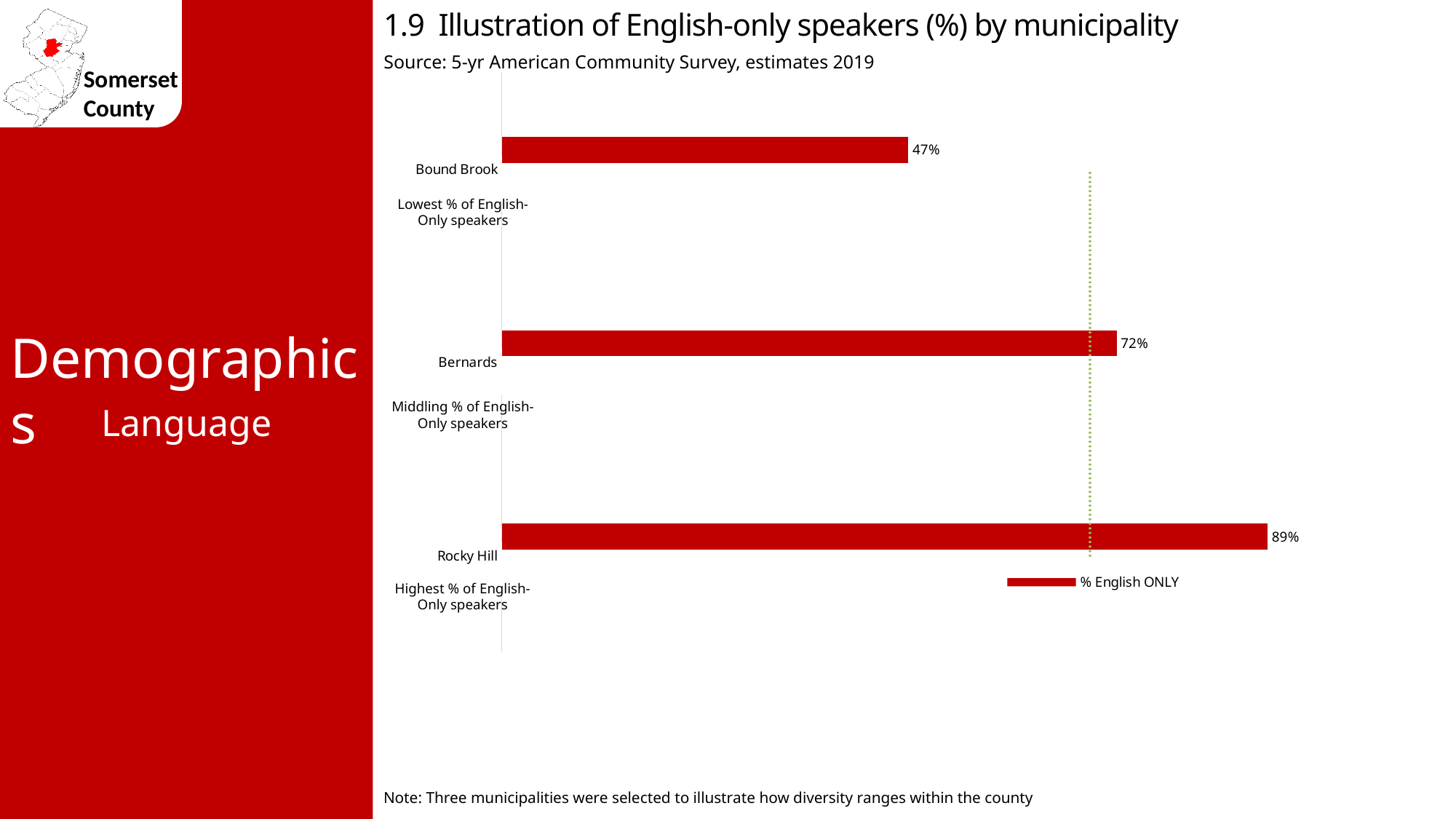
Which has a higher percentage of English-only speakers, Bernards or Bound Brook? Bernards What is the difference in percentage points between Rocky Hill and Bound Brook? 42 What type of chart is shown on the slide? Bar chart Which municipality has the lowest percentage of English-only speakers? Bound Brook What is the difference in percentage points between Bernards and Bound Brook? 25 How many municipalities are shown in the chart? 3 What is the percentage of English-only speakers in Rocky Hill? 89% What is the percentage of English-only speakers in Bound Brook? 47% How many series does the legend list? 1 What is the legend entry for the series shown in the chart? % English ONLY Which municipality has the highest percentage of English-only speakers? Rocky Hill What is the percentage of English-only speakers in Bernards? 72%